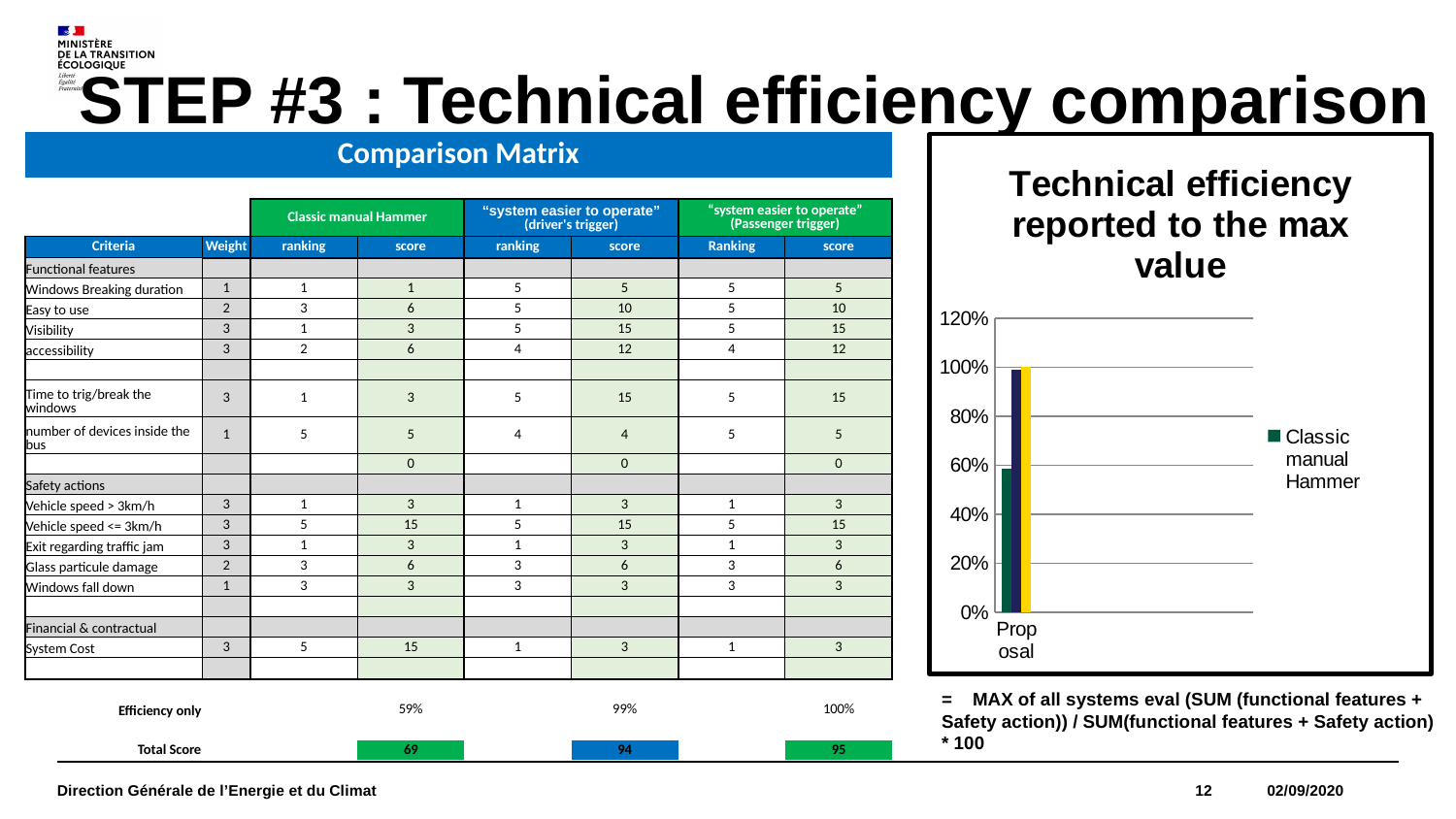
How many bars are plotted in the chart? 3 Which series name is listed in the chart's legend? Classic manual Hammer Which bar in the chart is the lowest? Classic manual Hammer (green bar) What kind of chart is shown on the right side of the slide? bar chart Which is larger in the chart, the green bar or the yellow bar? the yellow bar What is the label of the category on the x axis of the chart? Proposal Is the value for Classic manual Hammer in the chart greater or less than 40%? greater How many categories are shown on the x axis of the chart? 1 Is the value of the dark blue bar in the chart greater or less than 60%? greater Is the value of the yellow bar in the chart greater or less than 80%? greater What is the title of the chart on the slide? Technical efficiency reported to the max value